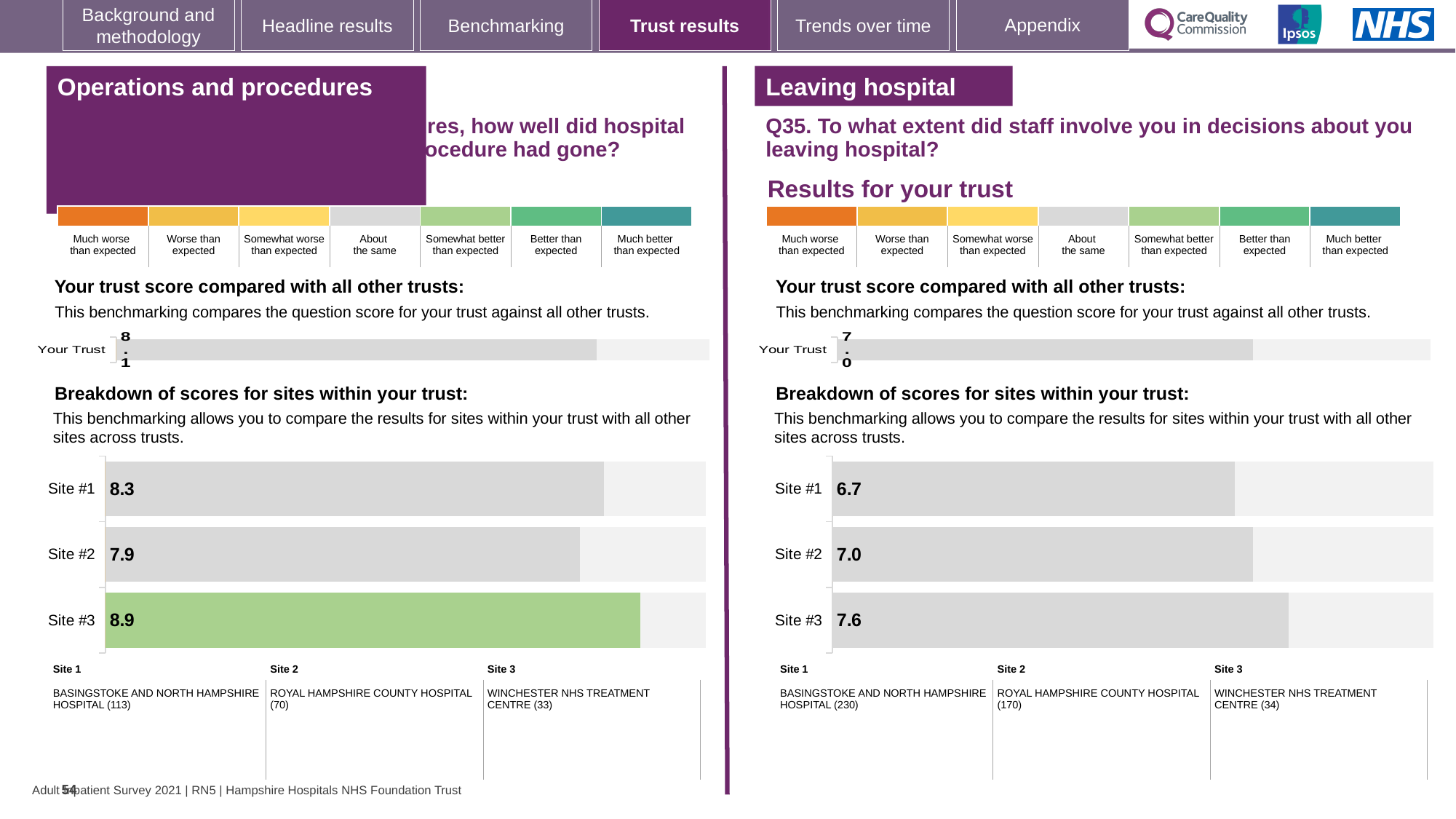
In the 'Leaving hospital' site breakdown chart on the right, which site has the lowest score? Site #1 In the 'Your trust score compared with all other trusts' chart under 'Leaving hospital' on the right, what is the score for Your Trust? 7.0 In the 'Leaving hospital' site breakdown chart on the right, which has a higher score, Site #2 or Site #3? Site #3 In the 'Operations and procedures' site breakdown chart on the left, which site has the highest score? Site #3 In the 'Operations and procedures' site breakdown chart on the left, what is the score for Site #1? 8.3 How many sites are shown in the 'Operations and procedures' site breakdown chart on the left? 3 What type of chart is used for the site breakdown under 'Leaving hospital' on the right? Bar chart In the 'Leaving hospital' site breakdown chart on the right, what is the difference between the scores for Site #3 and Site #1? 0.9 In the 'Operations and procedures' site breakdown chart on the left, which site's bar is coloured green? Site #3 In the 'Leaving hospital' site breakdown chart on the right, what is the score for Site #2? 7.0 In the 'Operations and procedures' site breakdown chart on the left, what is the score for Site #3? 8.9 In the 'Operations and procedures' site breakdown chart on the left, what is the difference between the scores for Site #3 and Site #2? 1.0